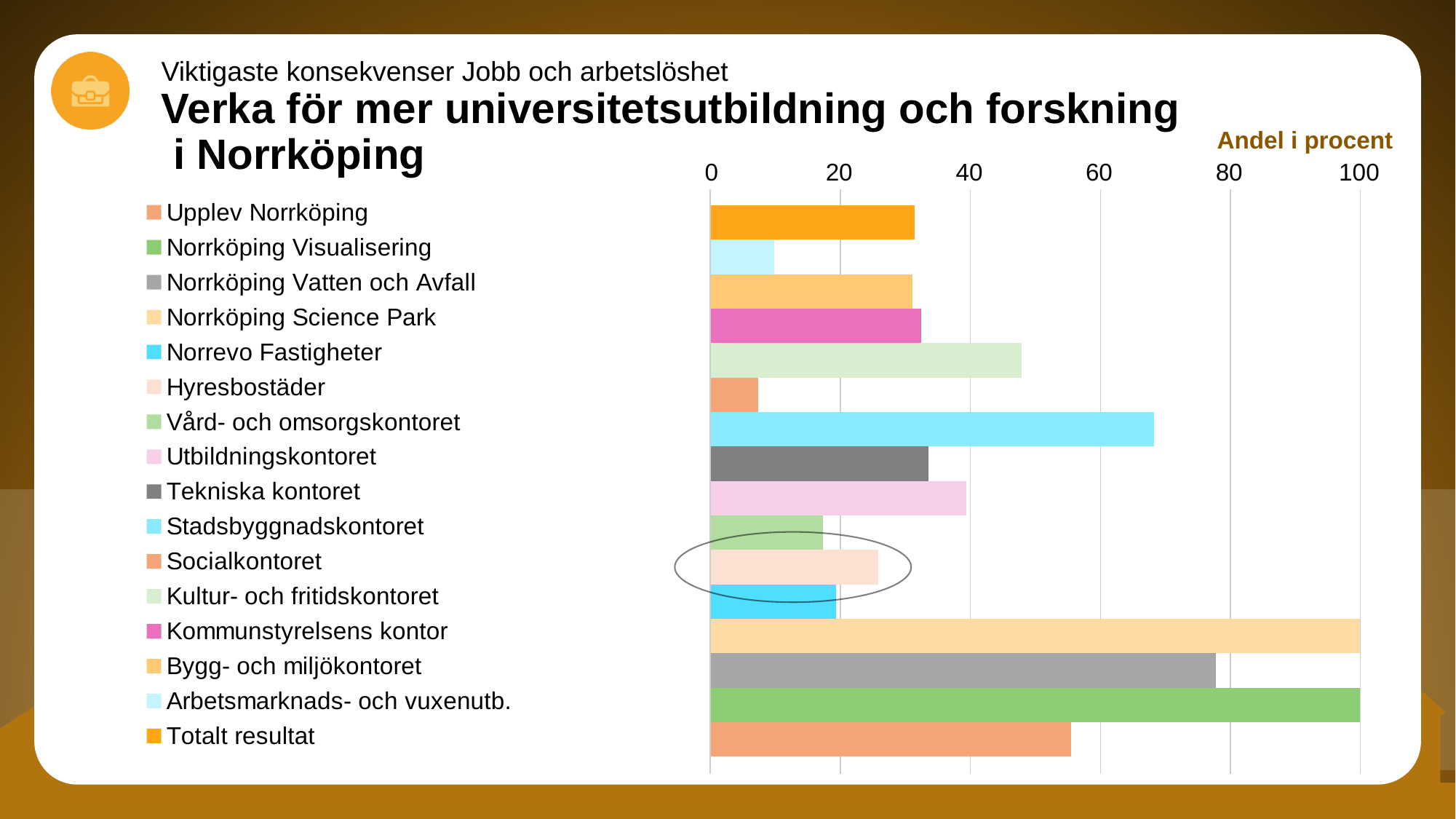
Is the value for Kultur- och fritidskontoret greater or less than 40? greater What is the label shown above the horizontal axis of the chart? Andel i procent Which is larger, the value for Stadsbyggnadskontoret or the value for Upplev Norrköping? Stadsbyggnadskontoret How many entries does the legend list? 16 Is the value for Totalt resultat greater or less than 20? greater Is the value for Arbetsmarknads- och vuxenutb. greater or less than 20? less Which is larger, the value for Kultur- och fritidskontoret or the value for Utbildningskontoret? Kultur- och fritidskontoret What is the value for Norrköping Science Park? 100 What kind of chart is shown on the slide? bar chart What is the value for Norrköping Visualisering? 100